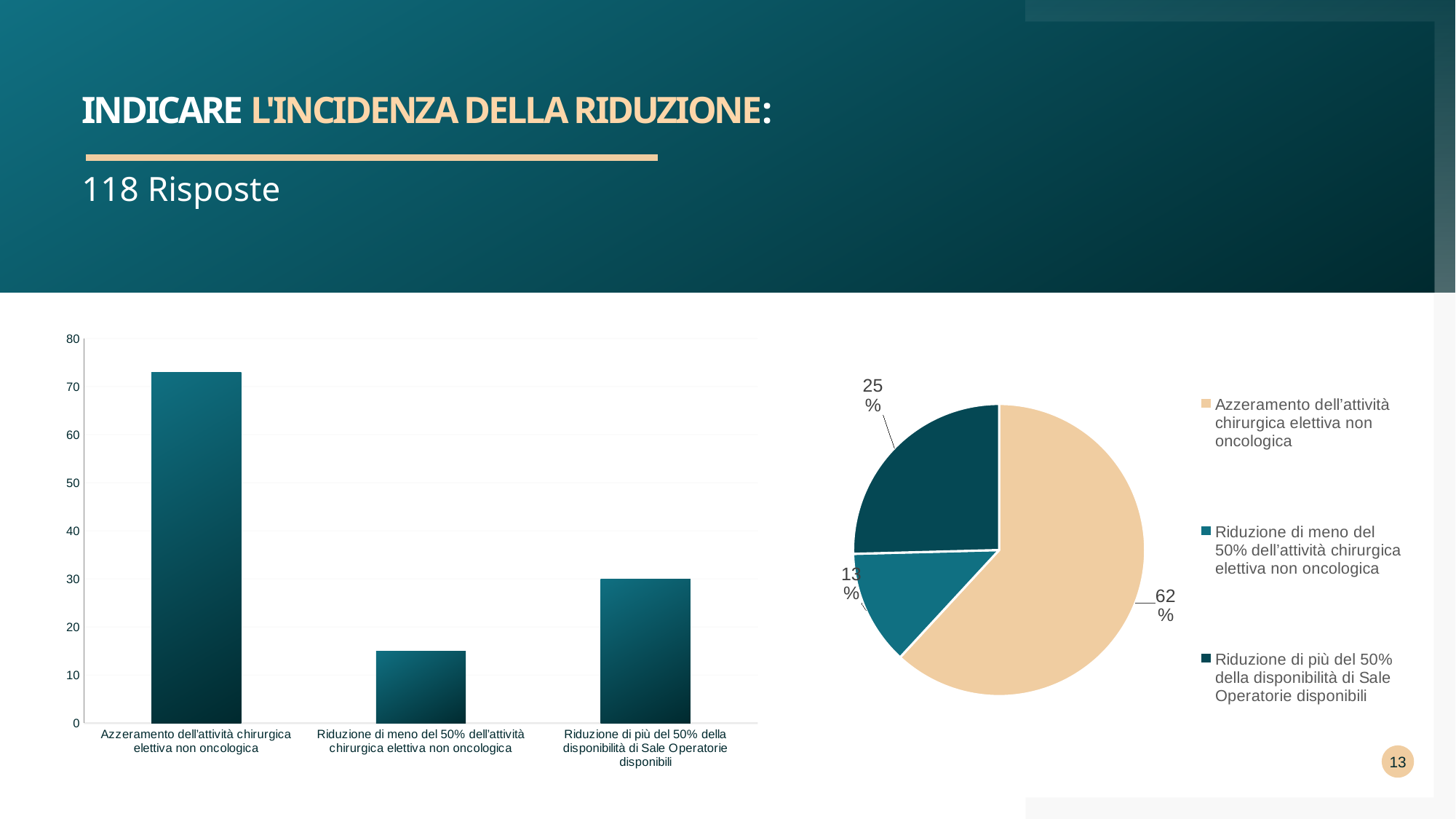
In the bar chart on the left, which is larger: the bar for Riduzione di più del 50% della disponibilità di Sale Operatorie disponibili or the bar for Riduzione di meno del 50% dell'attività chirurgica elettiva non oncologica? Riduzione di più del 50% della disponibilità di Sale Operatorie disponibili In the bar chart on the left, which category has the highest bar? Azzeramento dell'attività chirurgica elettiva non oncologica How many entries does the legend of the pie chart on the right list? 3 In the bar chart on the left, how many categories are shown? 3 In the pie chart on the right, what share is shown for Riduzione di più del 50% della disponibilità di Sale Operatorie disponibili? 25% What kind of chart is the chart on the right of the slide? pie chart In the pie chart on the right, which slice is the smallest? Riduzione di meno del 50% dell'attività chirurgica elettiva non oncologica In the bar chart on the left, is the value for Riduzione di meno del 50% dell'attività chirurgica elettiva non oncologica greater or less than 20? less What kind of chart is the chart on the left of the slide? bar chart In the pie chart on the right, what share is shown for Azzeramento dell'attività chirurgica elettiva non oncologica? 62% In the bar chart on the left, is the value for Azzeramento dell'attività chirurgica elettiva non oncologica greater or less than 70? greater In the bar chart on the left, which category has the lowest bar? Riduzione di meno del 50% dell'attività chirurgica elettiva non oncologica